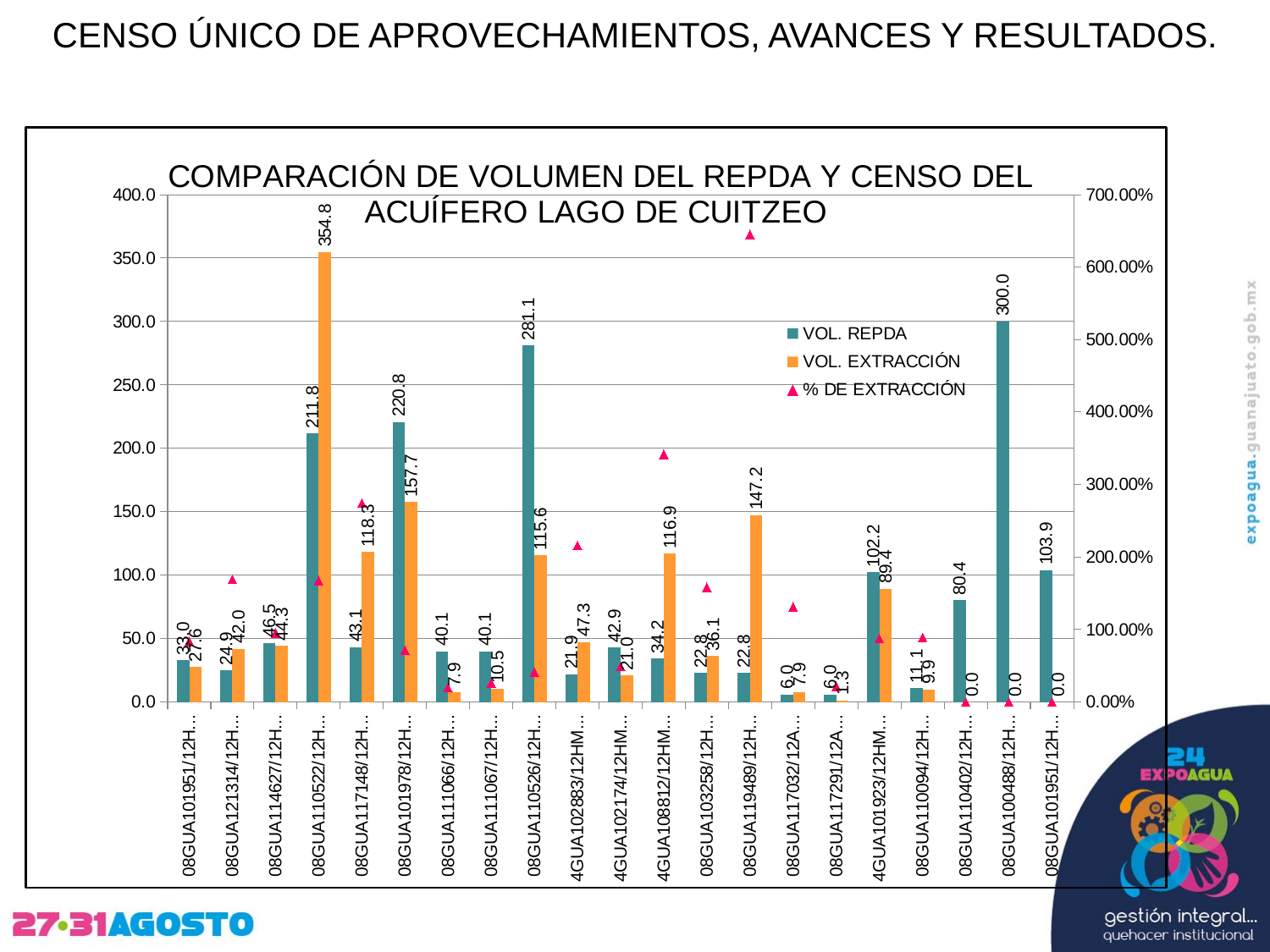
How many categories are plotted along the x axis? 21 Is the % DE EXTRACCIÓN value for 08GUA119489/12H... greater or less than 600.00%? greater For 08GUA101978/12H..., what is the difference between VOL. REPDA and VOL. EXTRACCIÓN? 63.1 How many series does the legend list? 3 What kind of chart is shown on the slide? bar chart What is the VOL. EXTRACCIÓN value for 08GUA117148/12H...? 118.3 What is the VOL. REPDA value for 08GUA110526/12H...? 281.1 What is the maximum value shown on the right-hand (secondary) axis? 700.00% Which category has the highest VOL. REPDA value? 08GUA100488/12H... For 08GUA119489/12H..., which is larger: VOL. REPDA or VOL. EXTRACCIÓN? VOL. EXTRACCIÓN What is the VOL. EXTRACCIÓN value for 08GUA110522/12H...? 354.8 Which category has the highest VOL. EXTRACCIÓN value? 08GUA110522/12H...